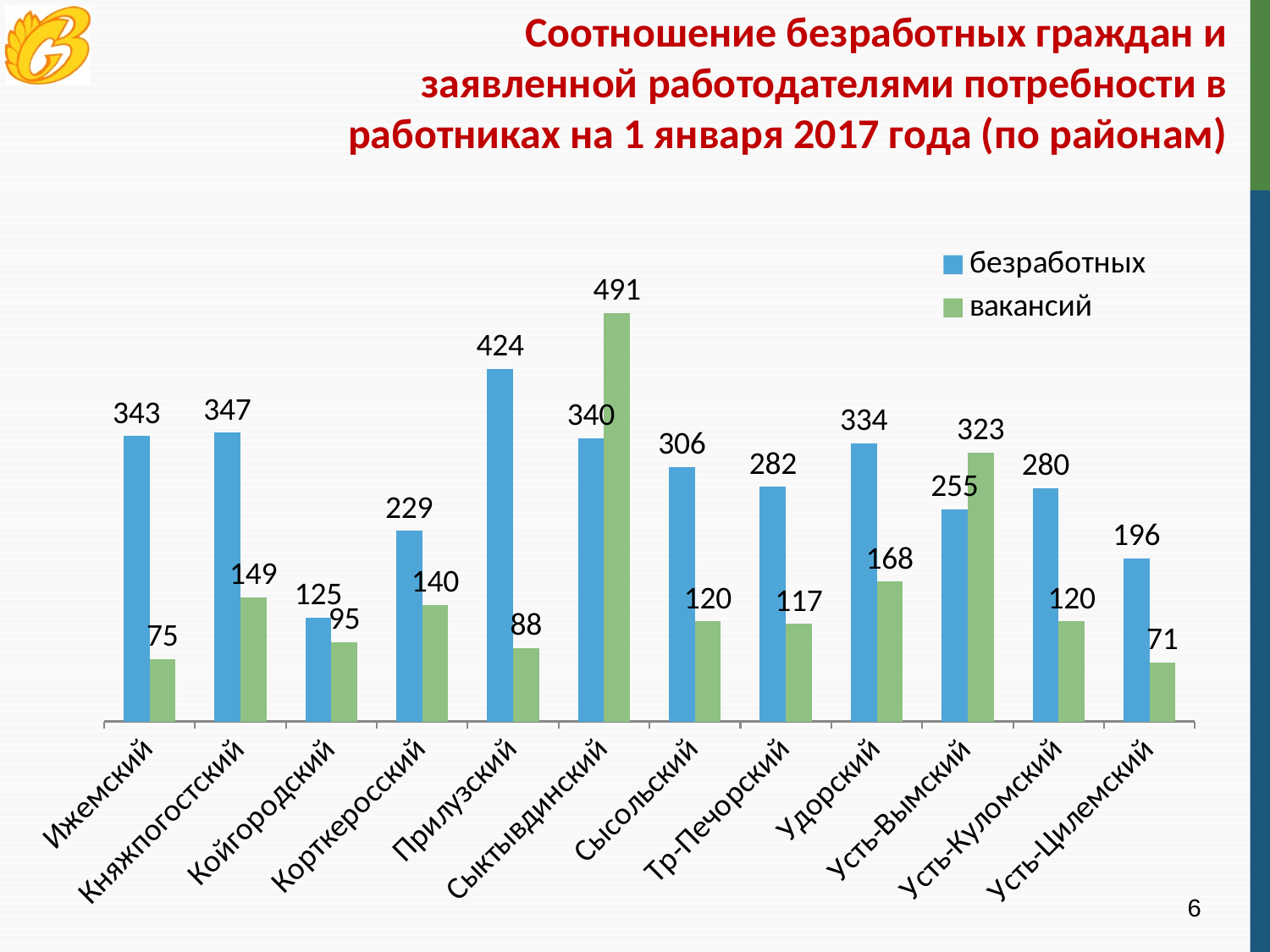
What kind of chart is shown on the slide? Bar chart What is the difference between безработных and вакансий for Прилузский? 336 What is the value of вакансий for Сыктывдинский? 491 How many districts are shown on the chart? 12 For Усть-Вымский, which is larger: безработных or вакансий? вакансий Which district has the highest value of безработных? Прилузский What is the difference between вакансий and безработных for Сыктывдинский? 151 How many series does the legend list? 2 What is the value of безработных for Прилузский? 424 Which district has the lowest value of безработных? Койгородский What is the value of вакансий for Удорский? 168 Which district has the lowest value of вакансий? Усть-Цилемский